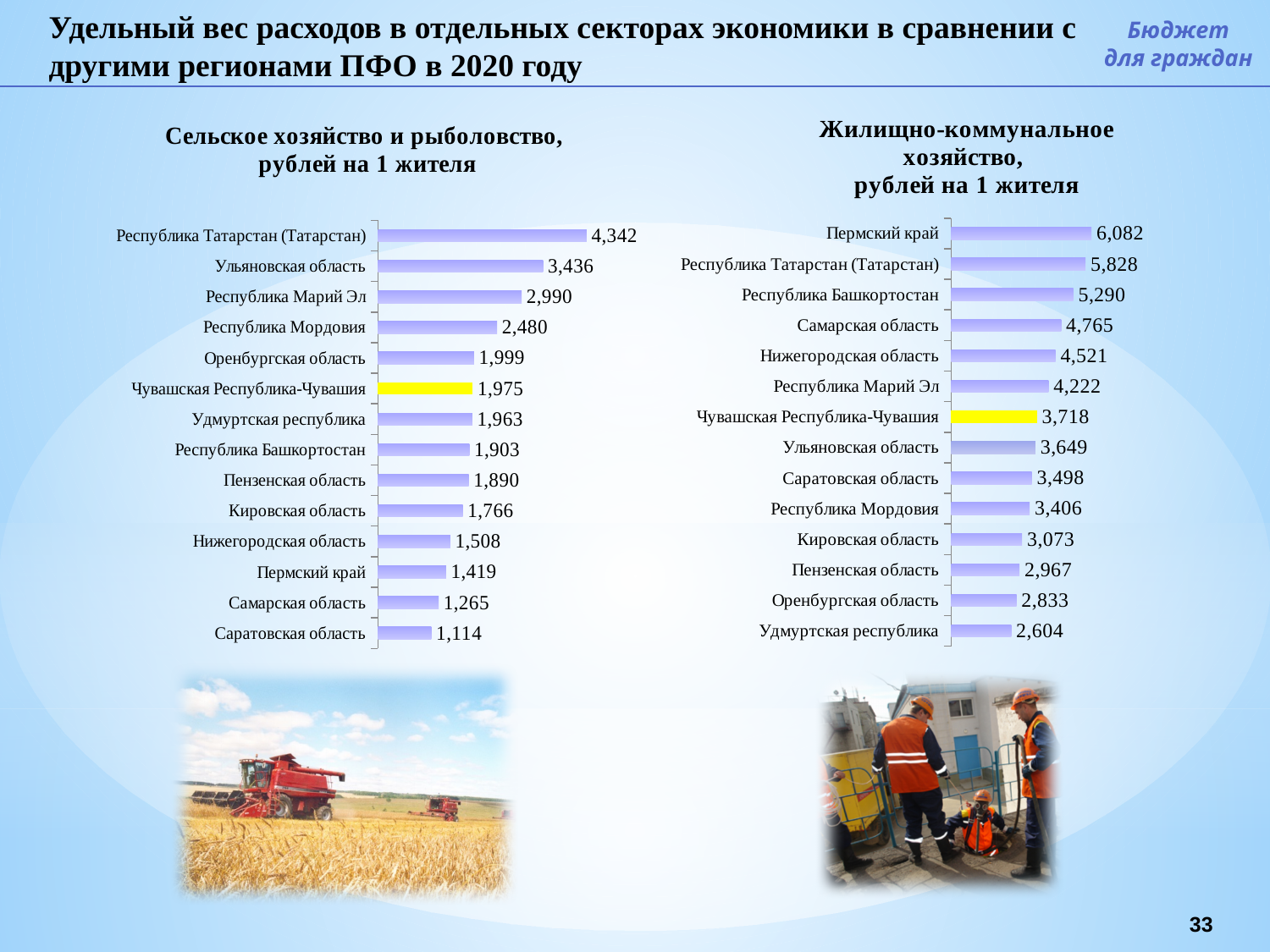
In the right chart (Жилищно-коммунальное хозяйство), which region has the lowest value? Удмуртская республика In the left chart (Сельское хозяйство и рыболовство), what is the value for Чувашская Республика-Чувашия? 1,975 In the right chart (Жилищно-коммунальное хозяйство), what is the value for Чувашская Республика-Чувашия? 3,718 In the left chart (Сельское хозяйство и рыболовство), what is the difference between Республика Татарстан (Татарстан) and Ульяновская область? 906 In the right chart (Жилищно-коммунальное хозяйство), which is larger: Самарская область or Нижегородская область? Самарская область In the right chart (Жилищно-коммунальное хозяйство), which region's bar is highlighted in yellow? Чувашская Республика-Чувашия In the left chart (Сельское хозяйство и рыболовство), how many regions are shown? 14 In the left chart (Сельское хозяйство и рыболовство), what is the value for Республика Татарстан (Татарстан)? 4,342 In the left chart (Сельское хозяйство и рыболовство), which region has the lowest value? Саратовская область In the right chart (Жилищно-коммунальное хозяйство), what is the value for Пермский край? 6,082 What type of chart is used on the left side of the slide? Bar chart In the right chart (Жилищно-коммунальное хозяйство), what is the difference between Пермский край and Удмуртская республика? 3,478